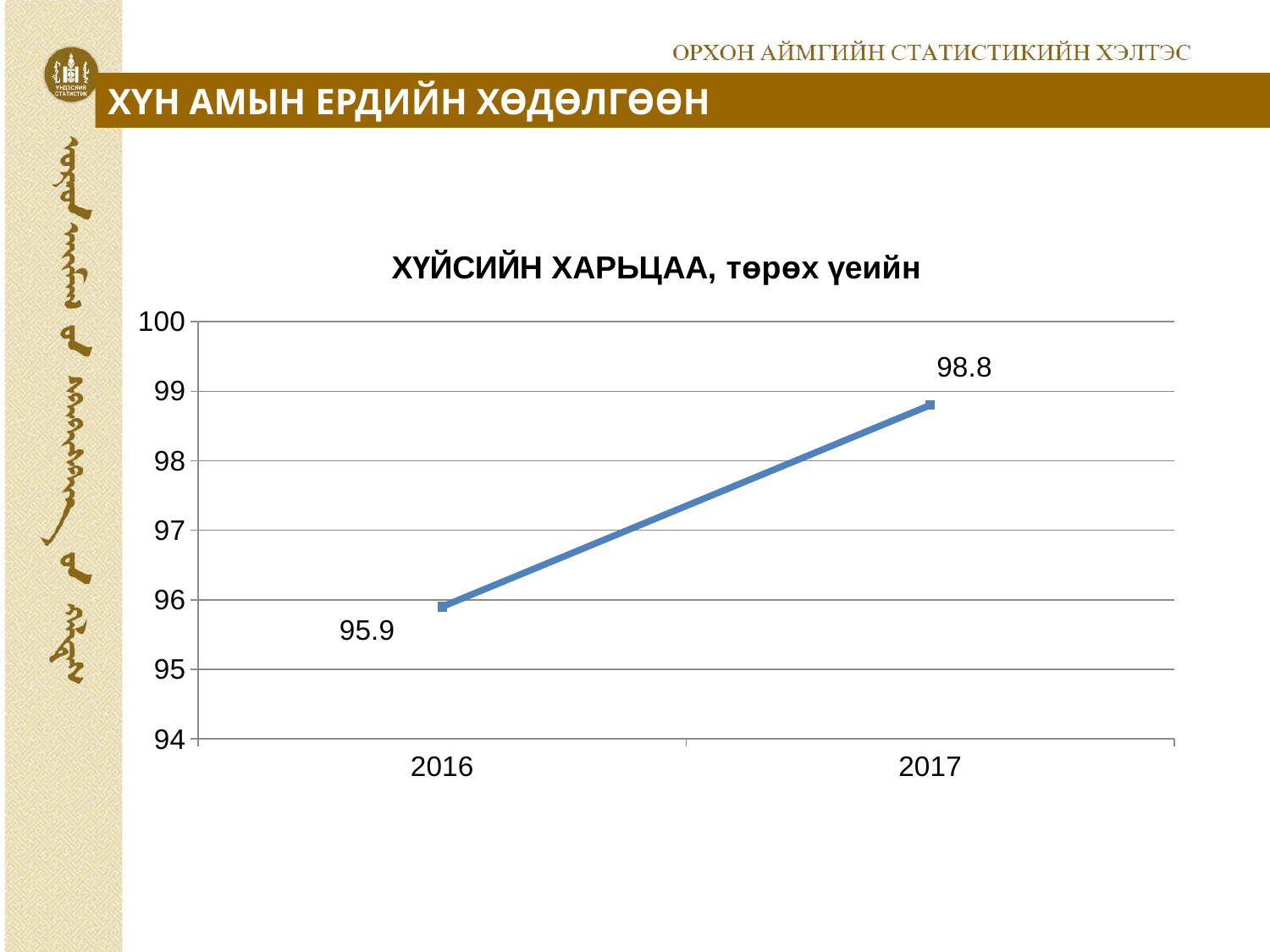
Which year has the lowest value? 2016 Which year has the highest value? 2017 Is the value for 2016 greater or less than 96? less What is the title of the chart? ХҮЙСИЙН ХАРЬЦАА, төрөх үеийн Which is larger, the value for 2016 or the value for 2017? 2017 Is the value for 2017 greater or less than 98? greater What is the difference between the values for 2017 and 2016? 2.9 Do the values rise or fall from 2016 to 2017? rise How many data points are plotted on the chart? 2 What kind of chart is shown on the slide? line chart What is the value for 2016? 95.9 What is the value for 2017? 98.8